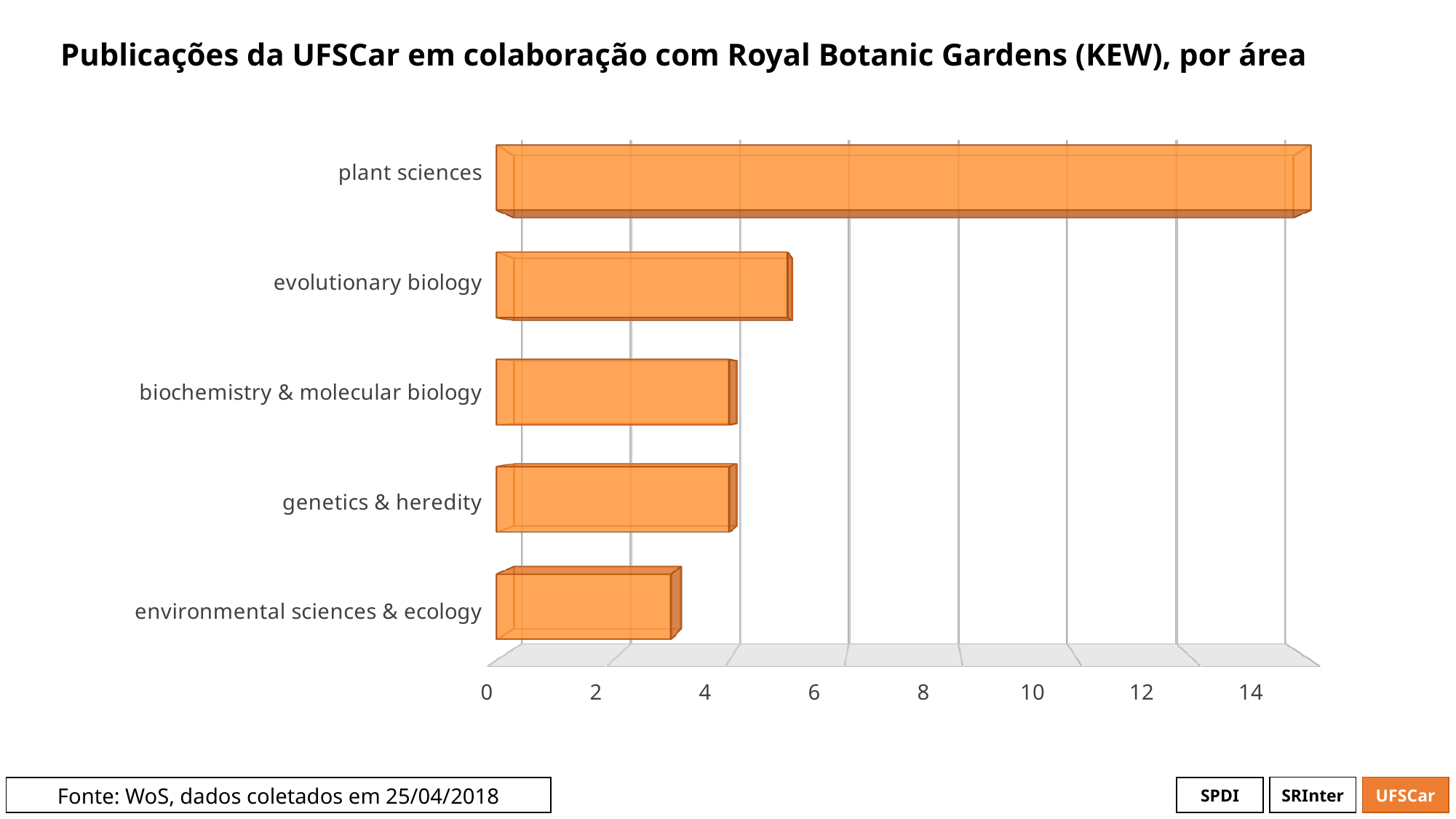
Which area has the lowest number of publications? environmental sciences & ecology Is the value for genetics & heredity greater or less than 6? less Is the value for environmental sciences & ecology greater or less than 4? less Which has more publications, plant sciences or biochemistry & molecular biology? plant sciences Which area has the highest number of publications? plant sciences How many categories (areas) are shown in the chart? 5 Is the value for evolutionary biology greater or less than 8? less What kind of chart is shown on the slide? bar chart Which has more publications, evolutionary biology or environmental sciences & ecology? evolutionary biology What is the title of the chart? Publicações da UFSCar em colaboração com Royal Botanic Gardens (KEW), por área